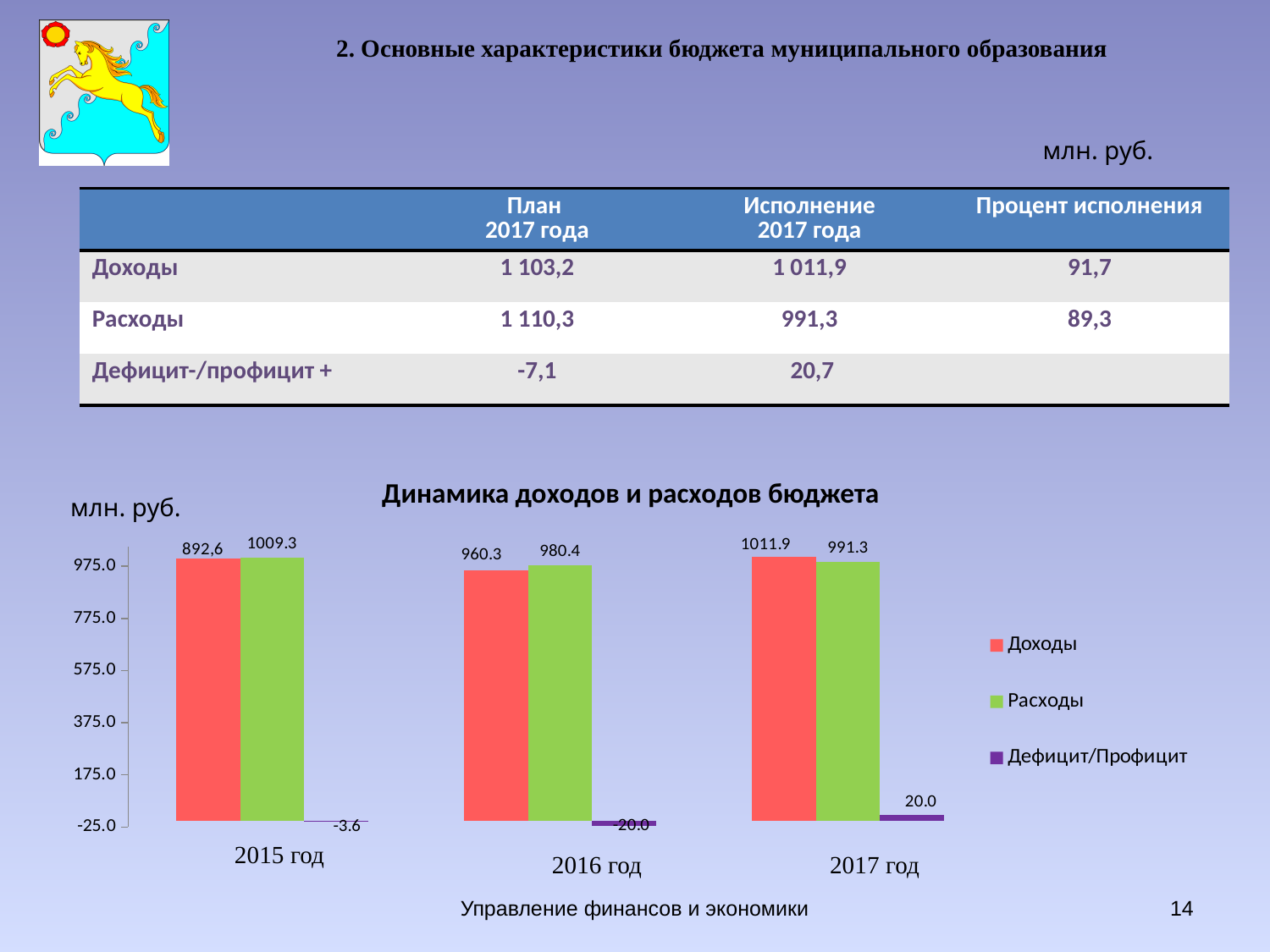
What is the difference between Расходы and Доходы for 2016 год in the chart? 20.1 What is the value of Дефицит/Профицит for 2017 год in the chart? 20.0 How many years are shown on the x axis of the chart? 3 For 2017 год, which is larger in the chart: Доходы or Расходы? Доходы What is the value of Доходы for 2015 год in the chart? 892,6 Do the Доходы values rise or fall from 2015 год to 2017 год in the chart? rise What is the value of Расходы for 2016 год in the chart? 980.4 In which year is Дефицит/Профицит lowest in the chart? 2016 год What is the value of Расходы for 2017 год in the chart? 991.3 What kind of chart is shown on the slide? bar chart How many series does the chart legend list? 3 In which year is Доходы highest in the chart? 2017 год